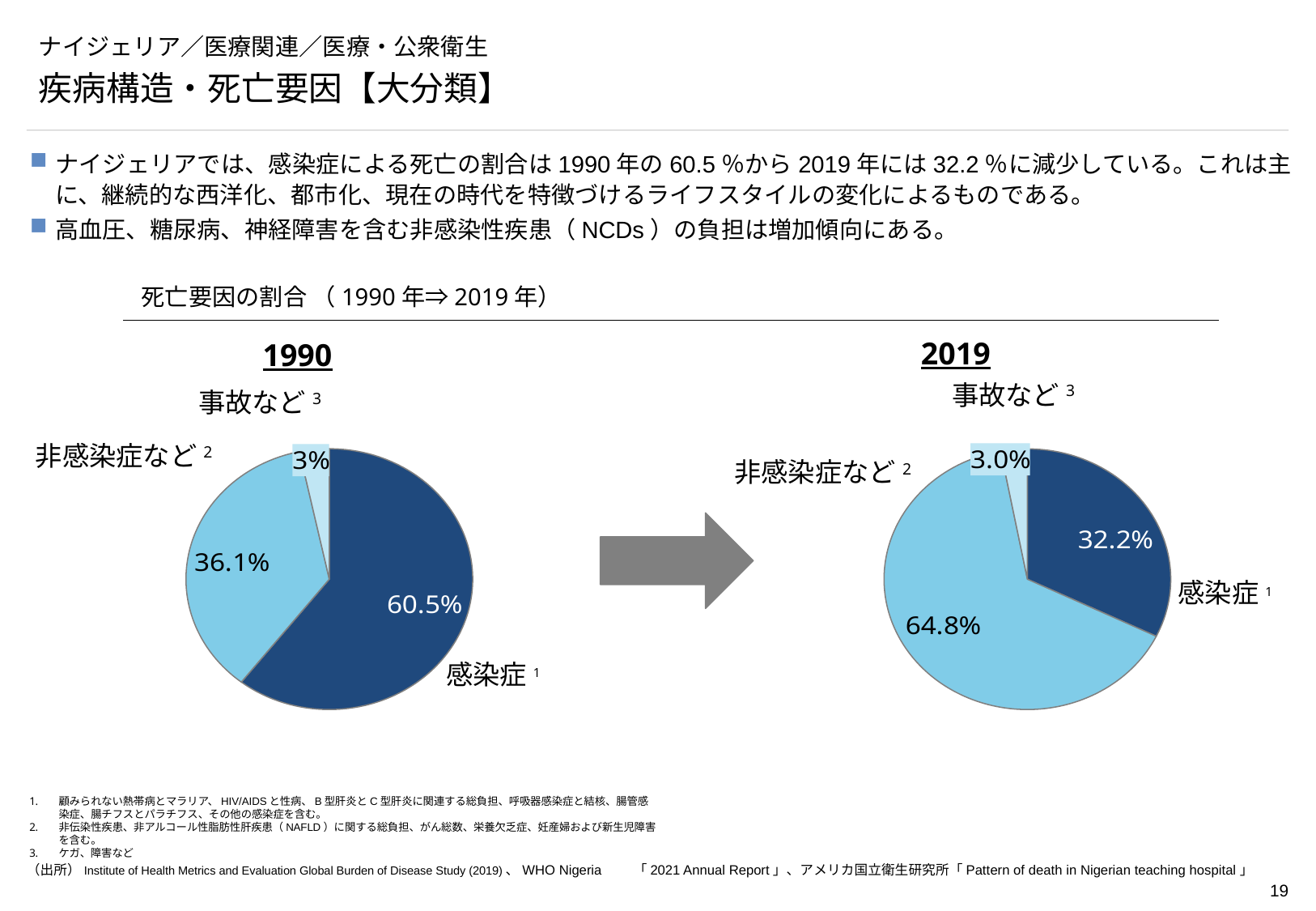
In the 2019 pie chart, what share of deaths is attributed to 非感染症など (non-communicable diseases etc.)? 64.8% Which is larger in the 2019 pie chart: the share for 感染症 or the share for 非感染症など? 非感染症など In the 1990 pie chart, which category has the largest share? 感染症 In the 2019 pie chart, which category has the largest share? 非感染症など In the 1990 pie chart, what share of deaths is attributed to 感染症 (infectious diseases)? 60.5% In the 2019 pie chart, which category has the smallest share? 事故など What is the difference between the 感染症 share in 1990 and in 2019? 28.3 percentage points In the 1990 pie chart, what share is shown for 事故など (accidents etc.)? 3% In the 2019 pie chart, what share is shown for 感染症 (infectious diseases)? 32.2% How many categories does each pie chart show? 3 In the 1990 pie chart, what is the difference between the 感染症 share and the 非感染症など share? 24.4 percentage points What type of chart is used to show the 死亡要因の割合 for 1990 and 2019? Pie chart